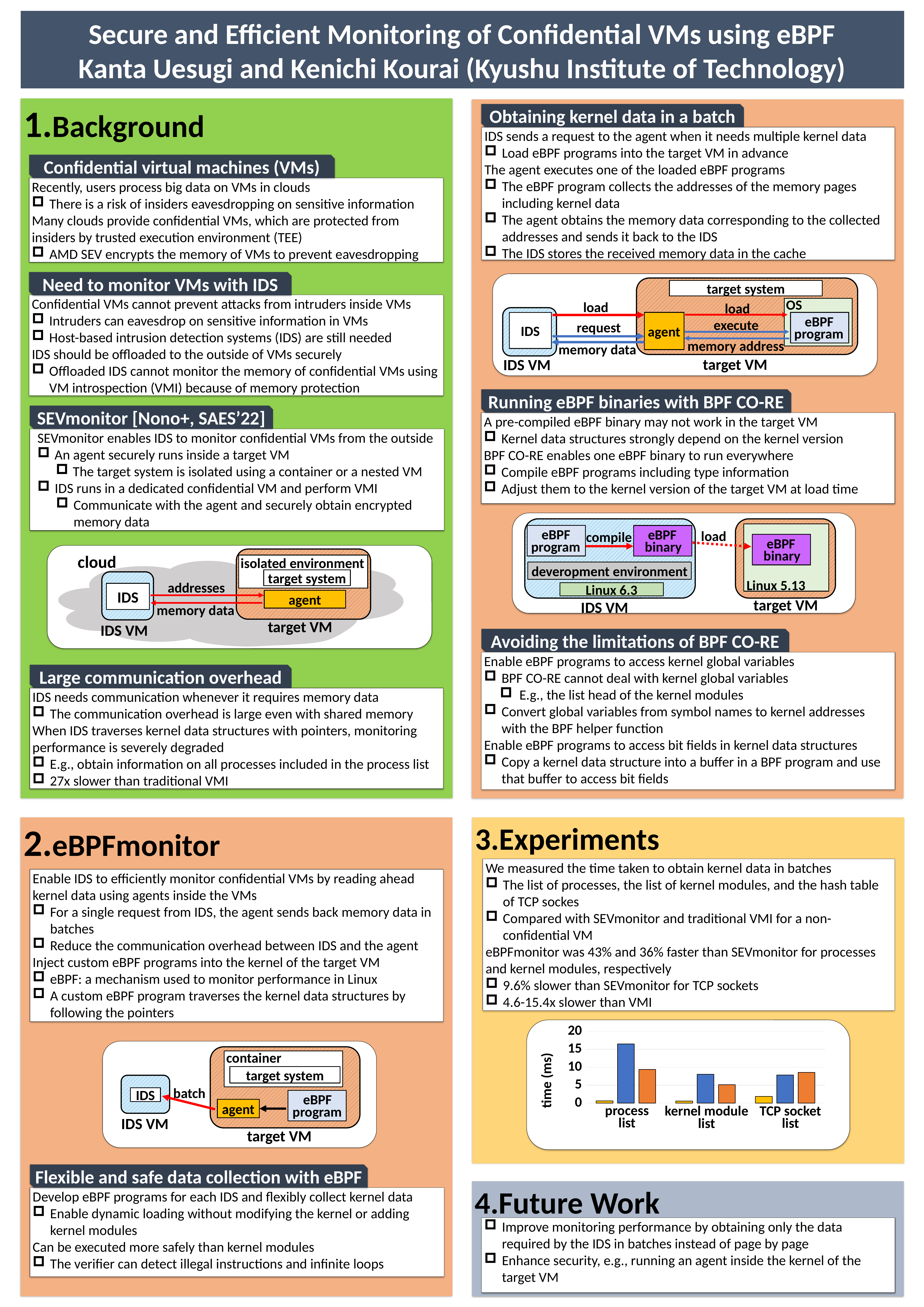
In the Experiments chart, is the yellow bar for TCP socket list greater or less than 5? less What is the highest tick value shown on the y axis of the Experiments chart? 20 How many categories are shown on the x axis of the Experiments chart? 3 What is the label of the y axis in the Experiments chart? time (ms) How many bars are plotted for each category in the Experiments chart? 3 In the Experiments chart, which is larger: the blue bar for process list or the blue bar for kernel module list? the blue bar for process list In the Experiments chart, is the orange bar for process list greater or less than 5? greater In the Experiments chart, is the blue bar for kernel module list greater or less than 10? less In the Experiments chart, for process list, which is larger: the blue bar or the orange bar? the blue bar What kind of chart is shown in the Experiments section? bar chart In the Experiments chart, which category contains the tallest bar? process list